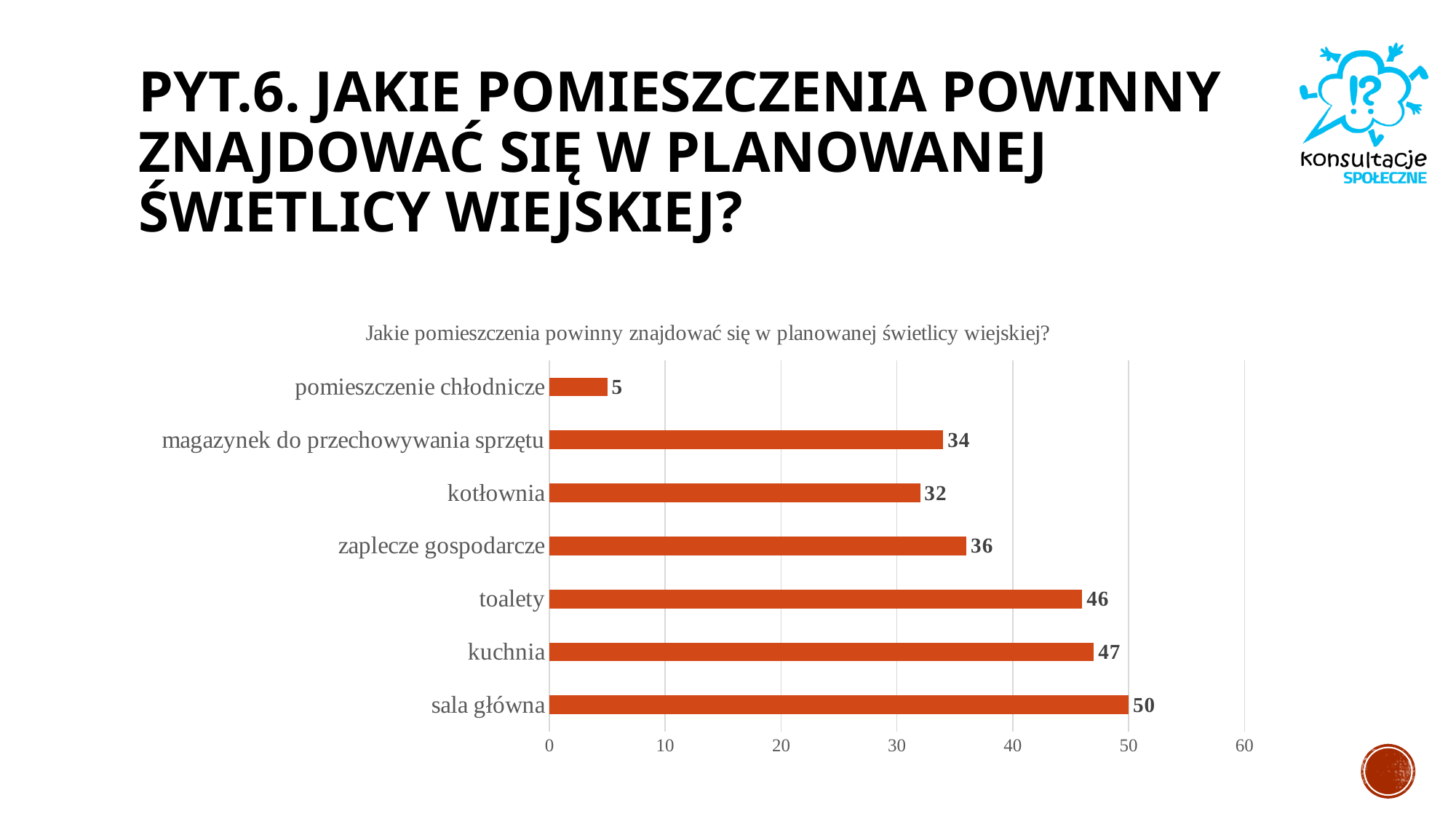
What is the difference between the values for "toalety" and "zaplecze gospodarcze"? 10 What is the value for "pomieszczenie chłodnicze"? 5 What is the difference between the values for "magazynek do przechowywania sprzętu" and "kotłownia"? 2 Which category has the lowest value? pomieszczenie chłodnicze Which is larger, the value for "kuchnia" or the value for "zaplecze gospodarcze"? kuchnia Is the value for "toalety" greater or less than 40? greater What is the value for "kotłownia"? 32 Which category has the highest value? sala główna How many categories are shown in the chart? 7 What is the value for "sala główna"? 50 What is the title of the chart? Jakie pomieszczenia powinny znajdować się w planowanej świetlicy wiejskiej? What kind of chart is shown on the slide? bar chart